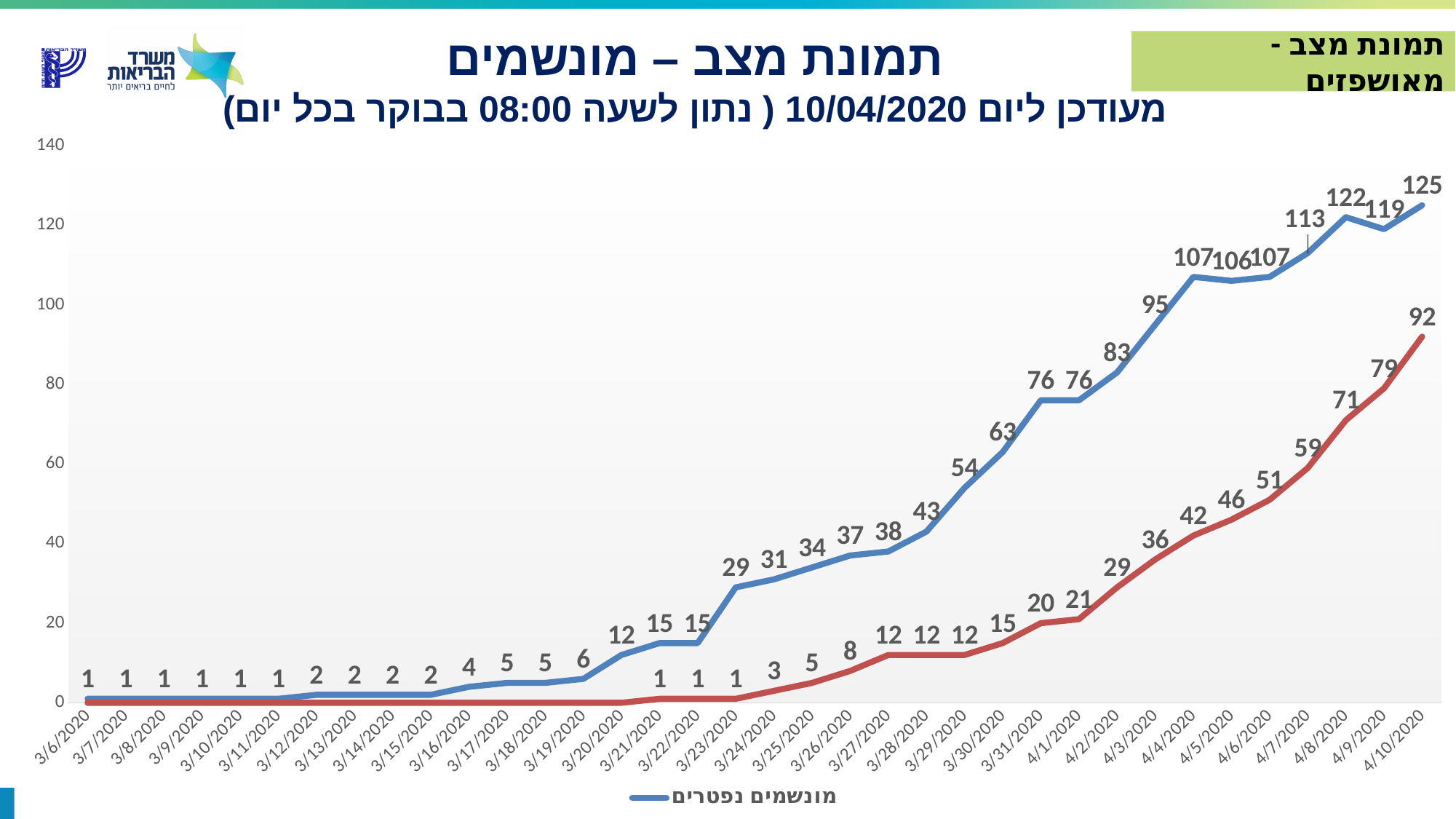
What is the value of the red line on 4/10/2020? 92 What is the difference between the blue line and the red line on 4/10/2020? 33 What is the value of the blue line on 4/10/2020? 125 What type of chart is shown on the slide? line chart What is the highest value shown on the y axis? 140 Does the red line generally rise or fall from 3/21/2020 to 4/10/2020? rise What is the value of the blue line on 3/23/2020? 29 What is the difference between the blue line's values on 4/8/2020 and 4/9/2020? 3 What is the value of the red line on 4/2/2020? 29 What is the highest value reached by the blue line? 125 How many dates are shown on the x axis? 36 Which line has the higher value on 4/4/2020, the blue line or the red line? the blue line